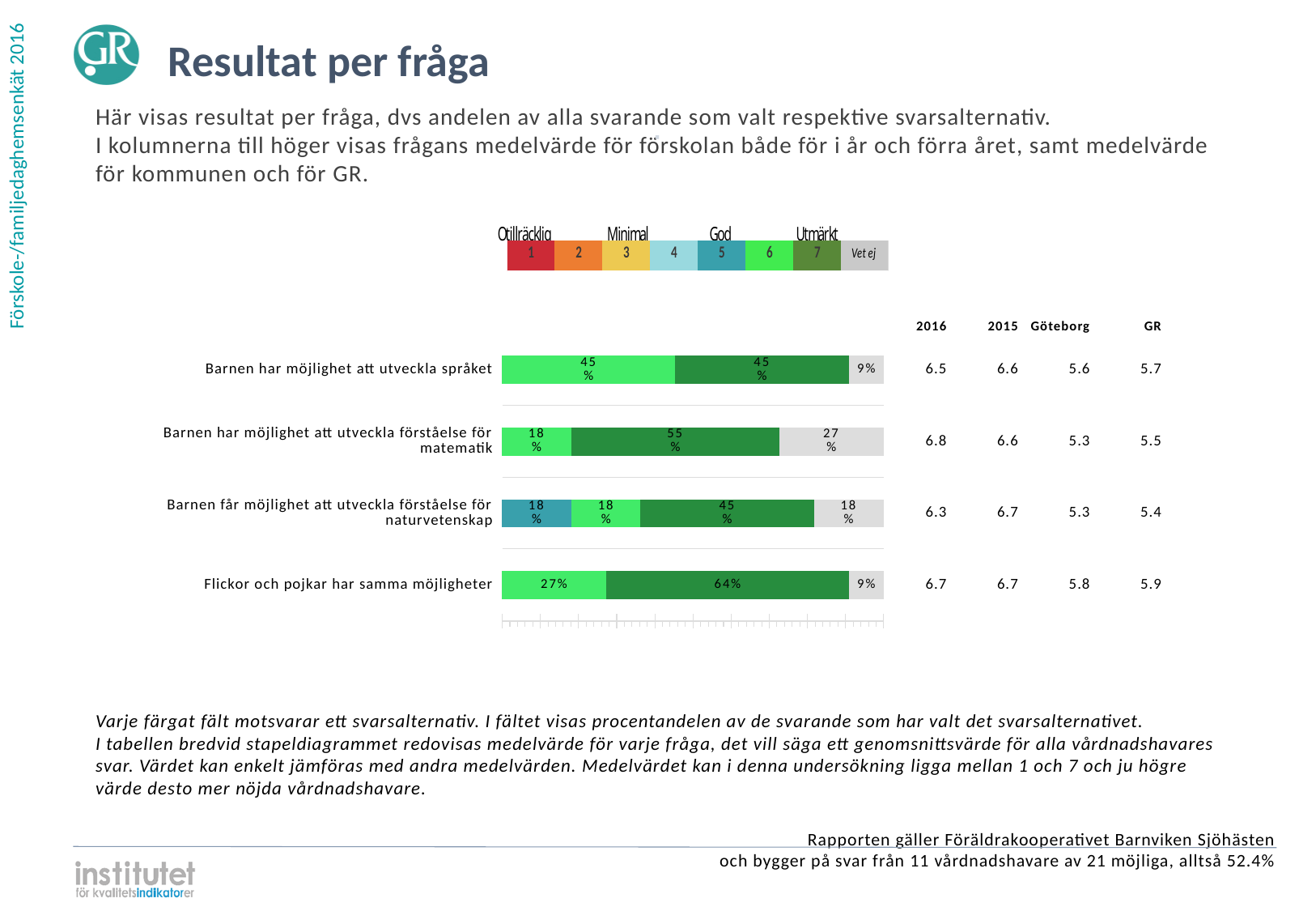
Is the 'Vet ej' share larger for 'Barnen har möjlighet att utveckla förståelse för matematik' or for 'Barnen har möjlighet att utveckla språket'? Barnen har möjlighet att utveckla förståelse för matematik What kind of chart is shown on the slide? stacked bar chart What is the difference between the dark green (7) share and the light green (6) share for 'Barnen har möjlighet att utveckla förståelse för matematik'? 37% What is the 2016 mean value shown for 'Barnen har möjlighet att utveckla förståelse för matematik'? 6.8 How many response alternatives does the legend above the chart list? 8 Which question has the largest share of respondents choosing the dark green alternative (7)? Flickor och pojkar har samma möjligheter What percentage of respondents chose the dark green alternative (7) for 'Flickor och pojkar har samma möjligheter'? 64% What percentage of respondents chose the teal alternative (5) for 'Barnen får möjlighet att utveckla förståelse för naturvetenskap'? 18% What label does the grey segment in the legend carry? Vet ej What percentage of respondents chose 'Vet ej' for 'Barnen har möjlighet att utveckla förståelse för matematik'? 27% How many questions (categories) are plotted in the bar chart? 4